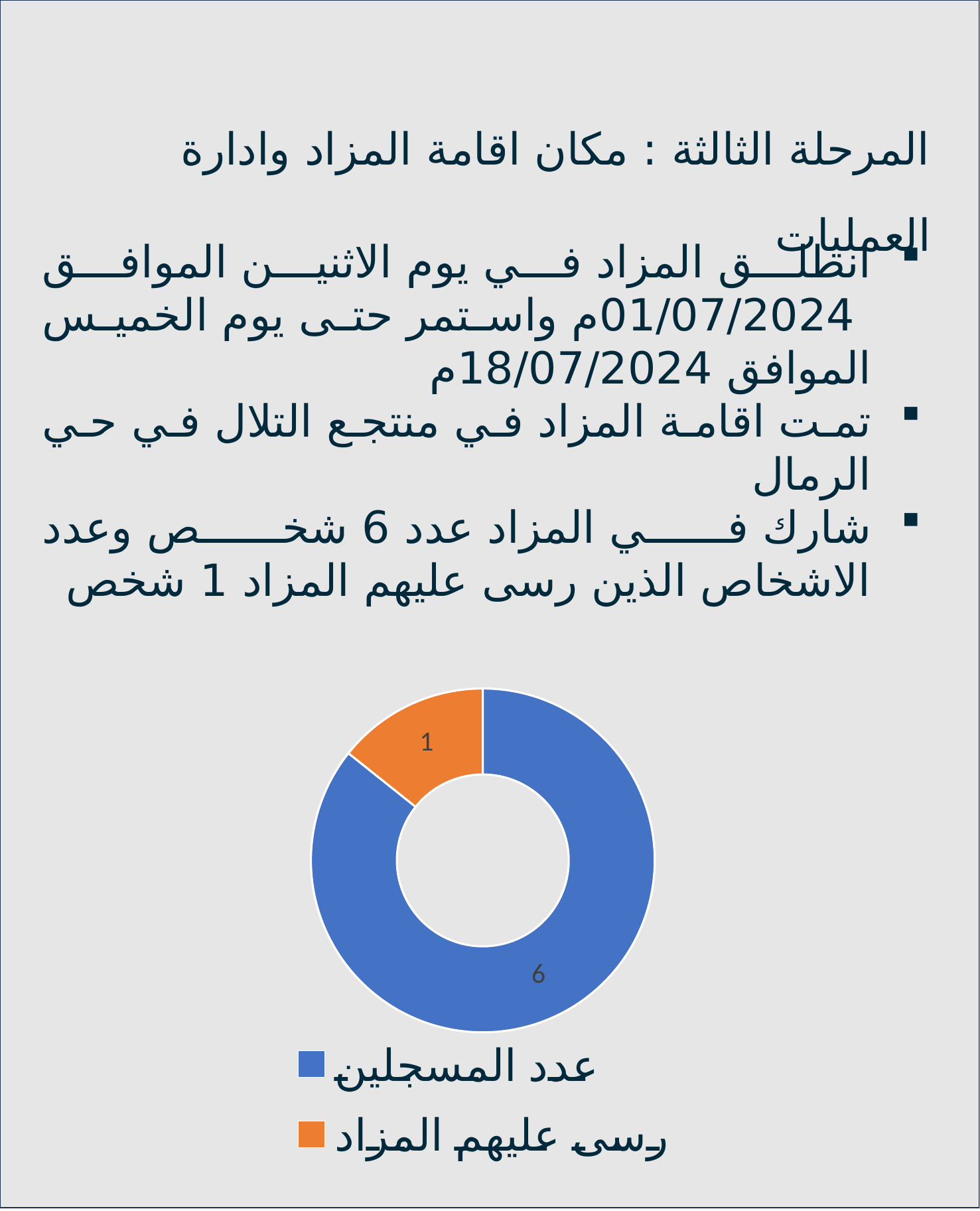
What kind of chart is shown on the slide? doughnut chart Which category has the largest slice in the chart? عدد المسجلين What fraction of the chart's total does عدد المسجلين represent? 6/7 What is the total of all the values shown in the chart? 7 Which category has the smallest slice in the chart? رسى عليهم المزاد What is the difference between the value for عدد المسجلين and the value for رسى عليهم المزاد? 5 What colour is the slice for رسى عليهم المزاد? orange What is the value for رسى عليهم المزاد in the chart? 1 Which is larger, the value for عدد المسجلين or the value for رسى عليهم المزاد? عدد المسجلين How many categories does the chart show? 2 What is the value for عدد المسجلين in the chart? 6 How many entries does the chart legend list? 2